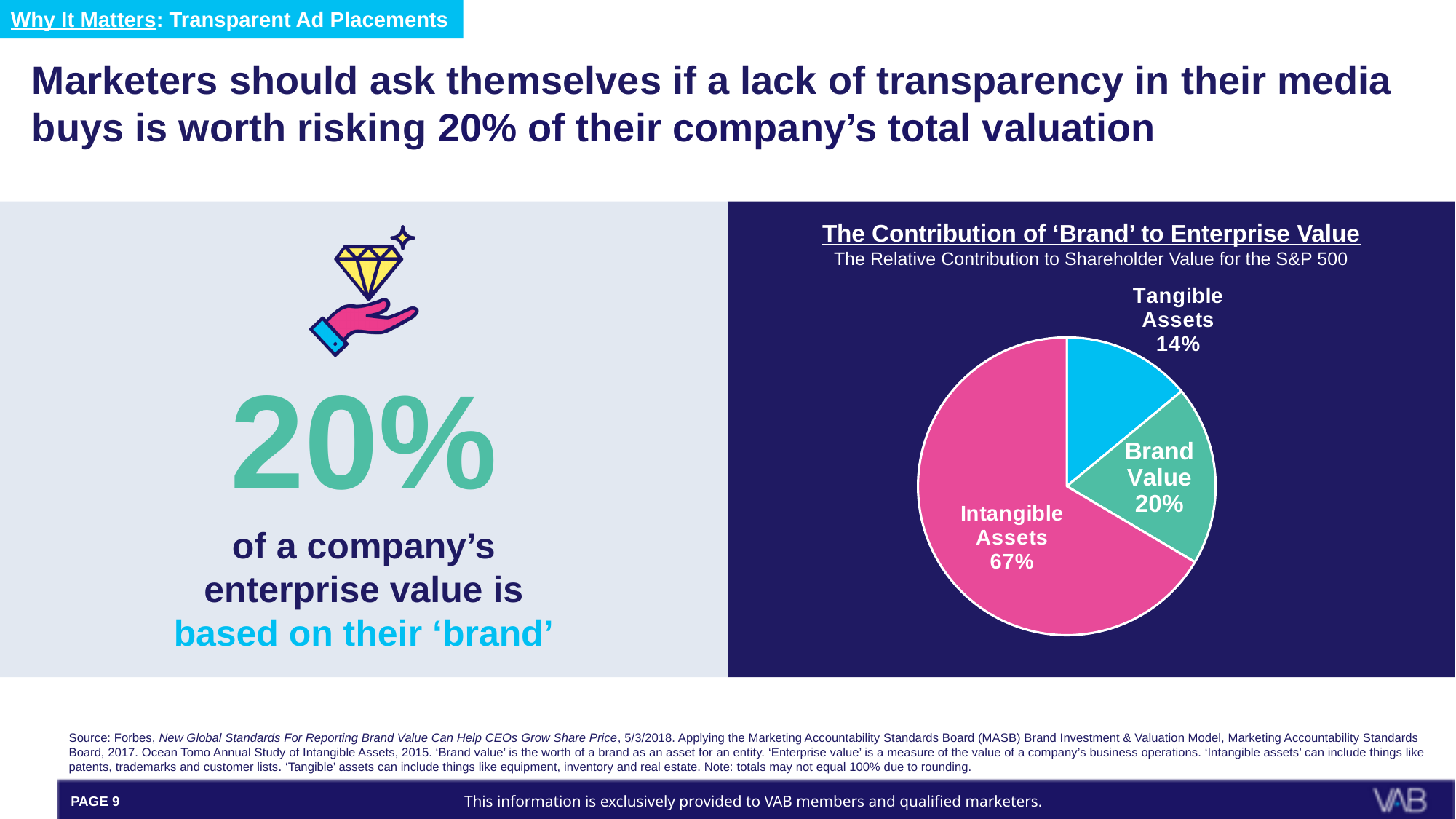
Which slice of the pie chart is the largest? Intangible Assets What share of enterprise value is attributed to Tangible Assets in the pie chart? 14% What is the difference in percentage points between the Intangible Assets slice and the Brand Value slice? 47 How many slices does the pie chart have? 3 What is the combined share of Brand Value and Tangible Assets in the pie chart? 34% What kind of chart is shown on the slide? Pie chart What colour is the Intangible Assets slice of the pie chart? Pink What share of enterprise value is attributed to Intangible Assets in the pie chart? 67% Which is larger in the pie chart, Brand Value or Tangible Assets? Brand Value What is the title of the chart? The Contribution of 'Brand' to Enterprise Value What share of enterprise value is attributed to Brand Value in the pie chart? 20% Which slice of the pie chart is the smallest? Tangible Assets